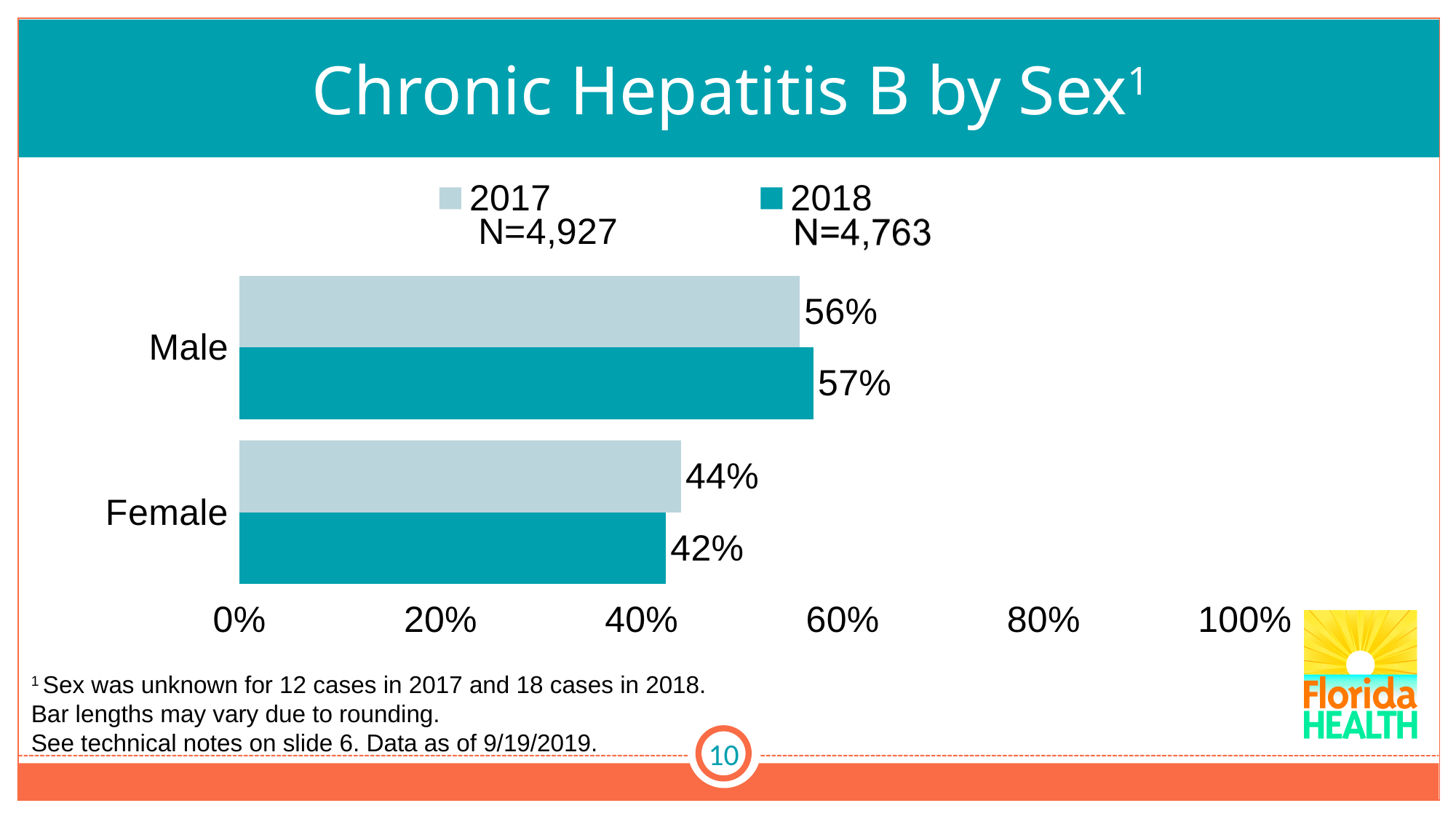
What kind of chart is shown on the slide? Bar chart Is the female percentage in 2018 greater or less than 60%? less Which sex had the higher share of chronic hepatitis B cases in 2018? Male What is the N value shown for 2018 in the legend? N=4,763 What percentage of chronic hepatitis B cases were male in 2017? 56% What percentage of chronic hepatitis B cases were female in 2018? 42% Which sex had the lower share of chronic hepatitis B cases in 2017? Female By how many percentage points did the female share change from 2017 to 2018? 2% How many series does the legend list? 2 What is the difference between the male and female percentages in 2018? 15% What percentage of chronic hepatitis B cases were male in 2018? 57% What percentage of chronic hepatitis B cases were female in 2017? 44%